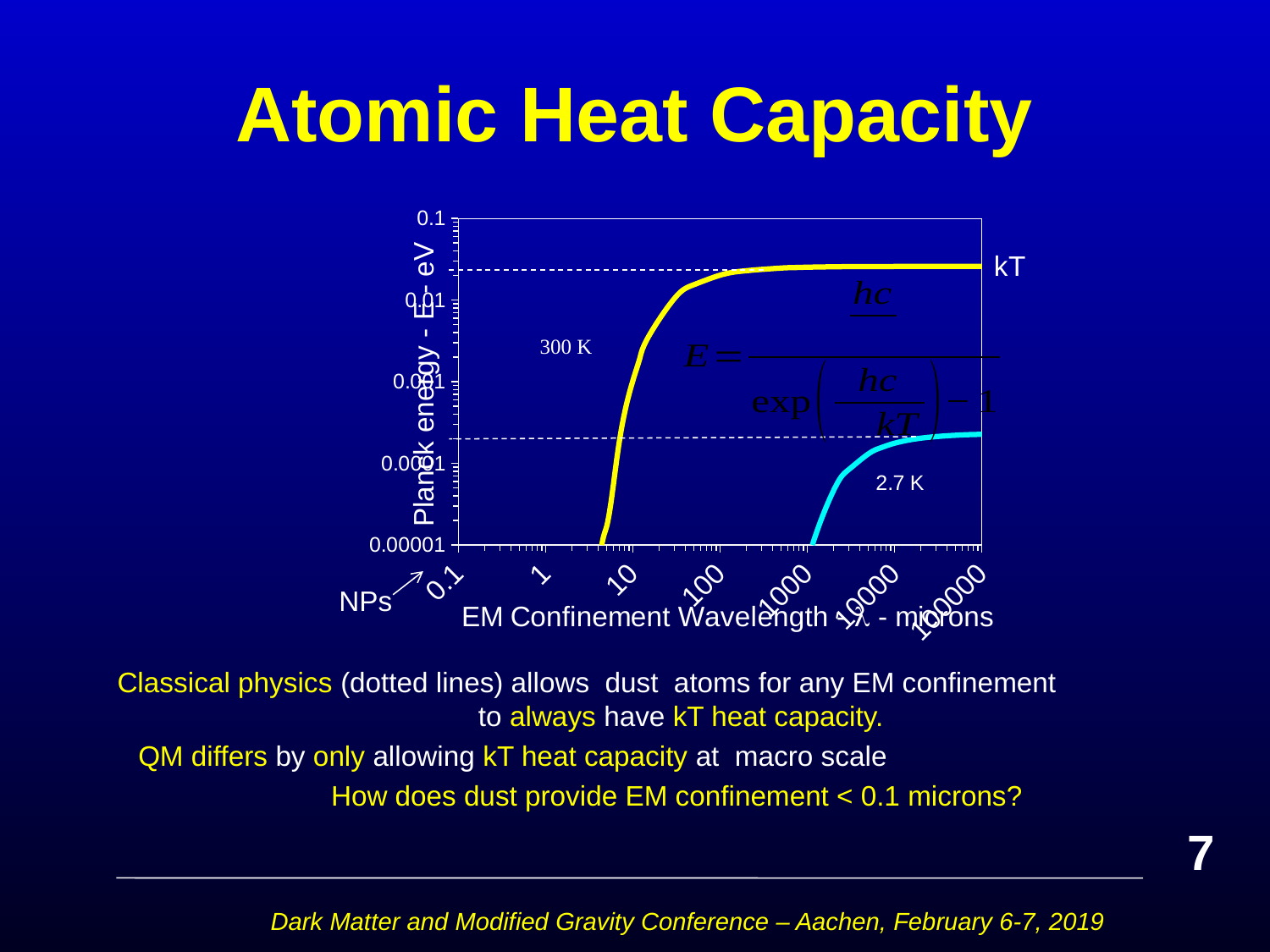
Is the Planck energy of the 300 K curve at 10000 microns greater or less than 0.01 eV? greater Is the Planck energy of the 2.7 K curve at 10000 microns greater or less than 0.001 eV? less Is the Planck energy of the 2.7 K curve at 100000 microns greater or less than 0.0001 eV? greater What is the label of the x axis of the chart? EM Confinement Wavelength λ - microns How many curves are plotted on the chart? 2 Does the Planck energy for the 300 K curve rise or fall as the EM confinement wavelength increases? rise What is the lowest value shown on the y axis of the chart? 0.00001 Which curve reaches the higher plateau in Planck energy, 300 K or 2.7 K? 300 K What temperatures label the two curves on the chart? 300 K and 2.7 K How many tick labels are shown on the x axis of the chart? 7 What kind of chart is shown on the slide? line chart At 10000 microns, which curve has the higher Planck energy, 300 K or 2.7 K? 300 K